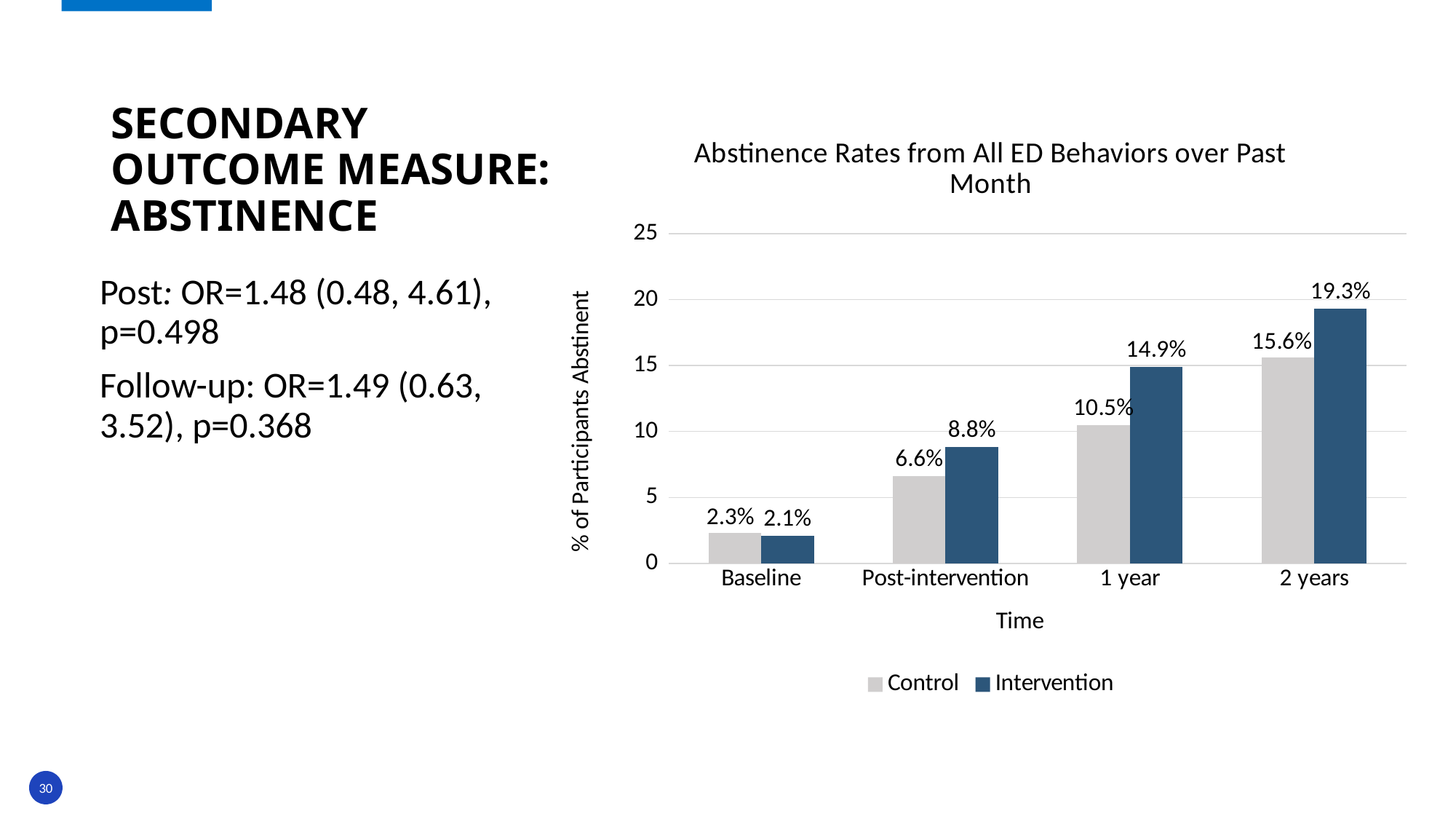
What is the Intervention value at 2 years? 19.3% Do the Control values rise or fall from Baseline to 2 years? rise What is the Control value at Post-intervention? 6.6% Is the Intervention value at Post-intervention greater or less than 10? less How many series does the legend list? 2 How many time points are shown on the x axis? 4 What is the difference between the Intervention and Control values at 1 year? 4.4% At which time point is the Control value lowest? Baseline Which is larger at Baseline, the Control value or the Intervention value? Control At which time point is the Intervention value highest? 2 years What kind of chart is shown? bar chart What is the Control value at 1 year? 10.5%